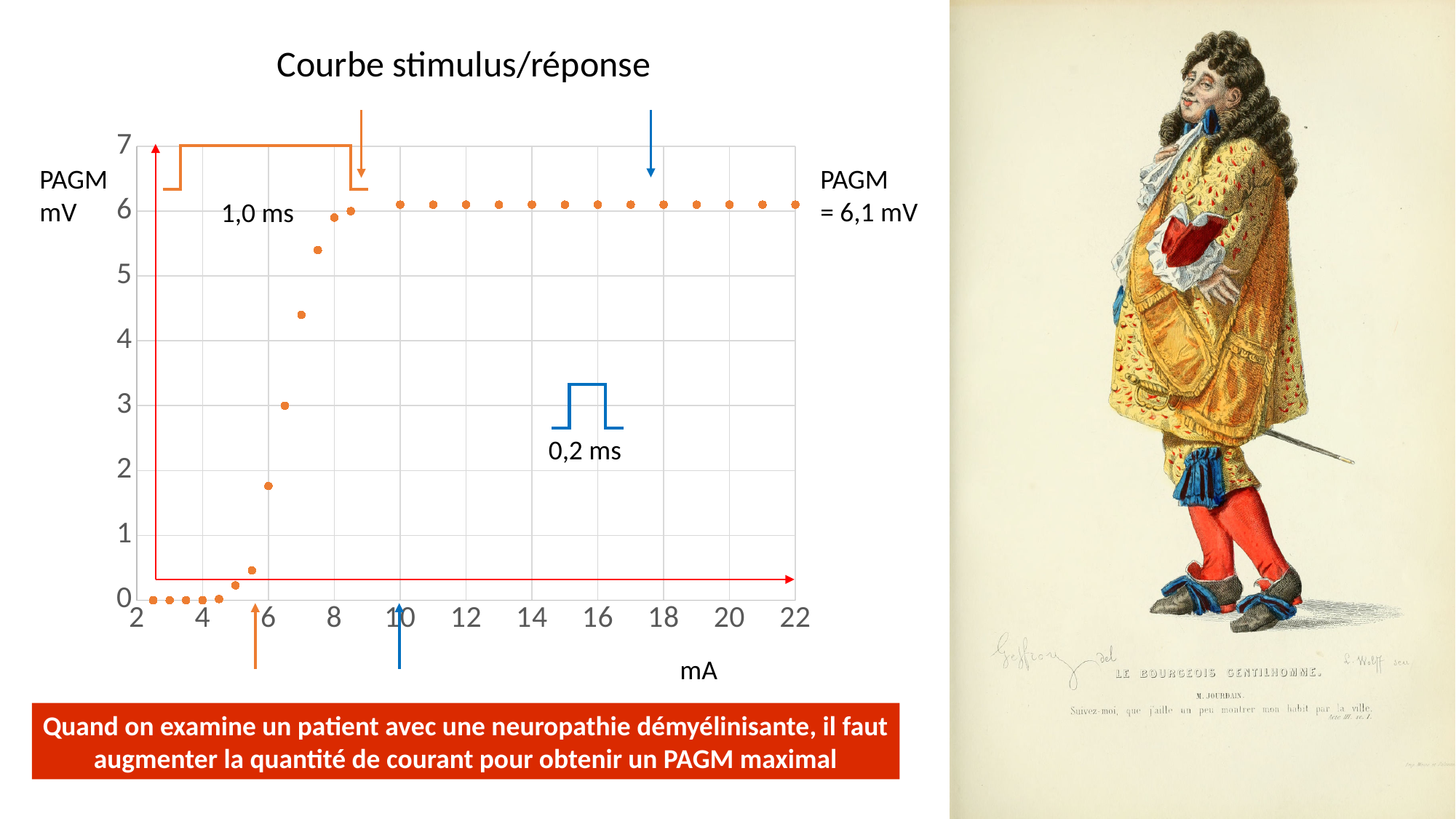
What unit is shown on the x axis of the chart? mA What is the highest value shown on the y axis of the chart? 7 Do the PAGM values rise or fall as the current increases from 5 mA to 8 mA? Rise What is the PAGM value at 3 mA? 0 What is the title of the chart? Courbe stimulus/réponse Is the PAGM value at 7.5 mA greater or less than 5 mV? greater What kind of chart is shown on the slide? Scatter chart Which has the larger PAGM value: the point at 6 mA or the point at 8 mA? 8 mA What is the maximal PAGM value reached by the curve, as annotated on the chart? 6,1 mV Is the PAGM value at 7 mA greater or less than 4 mV? greater Is the PAGM value at 5.5 mA greater or less than 1 mV? less